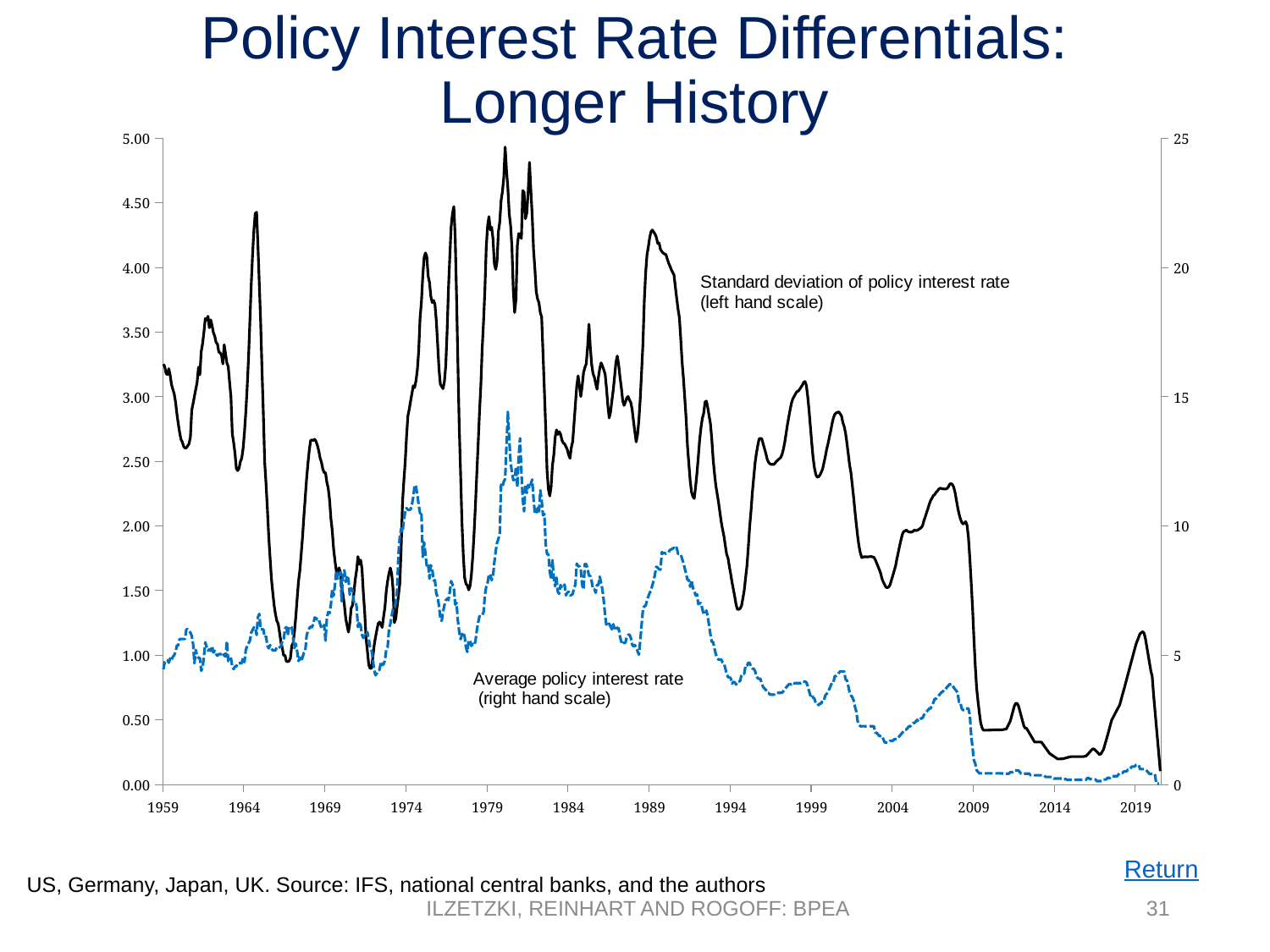
Overall, does the average policy interest rate rise or fall between 1990 and 2019? fall Which series is plotted against the right hand scale? Average policy interest rate What kind of chart is shown on the slide? line chart What is the title of the chart on the slide? Policy Interest Rate Differentials: Longer History How many series are plotted on the chart? 2 Is the average policy interest rate around 2014 greater or less than 5 on the right hand scale? less What is the first year labelled on the x axis? 1959 Is the peak of the standard deviation of policy interest rate around 1980 greater or less than 4.50 on the left hand scale? greater What is the maximum value shown on the left hand axis? 5.00 Is the peak of the average policy interest rate around 1980 greater or less than 10 on the right hand scale? greater What is the maximum value shown on the right hand axis? 25